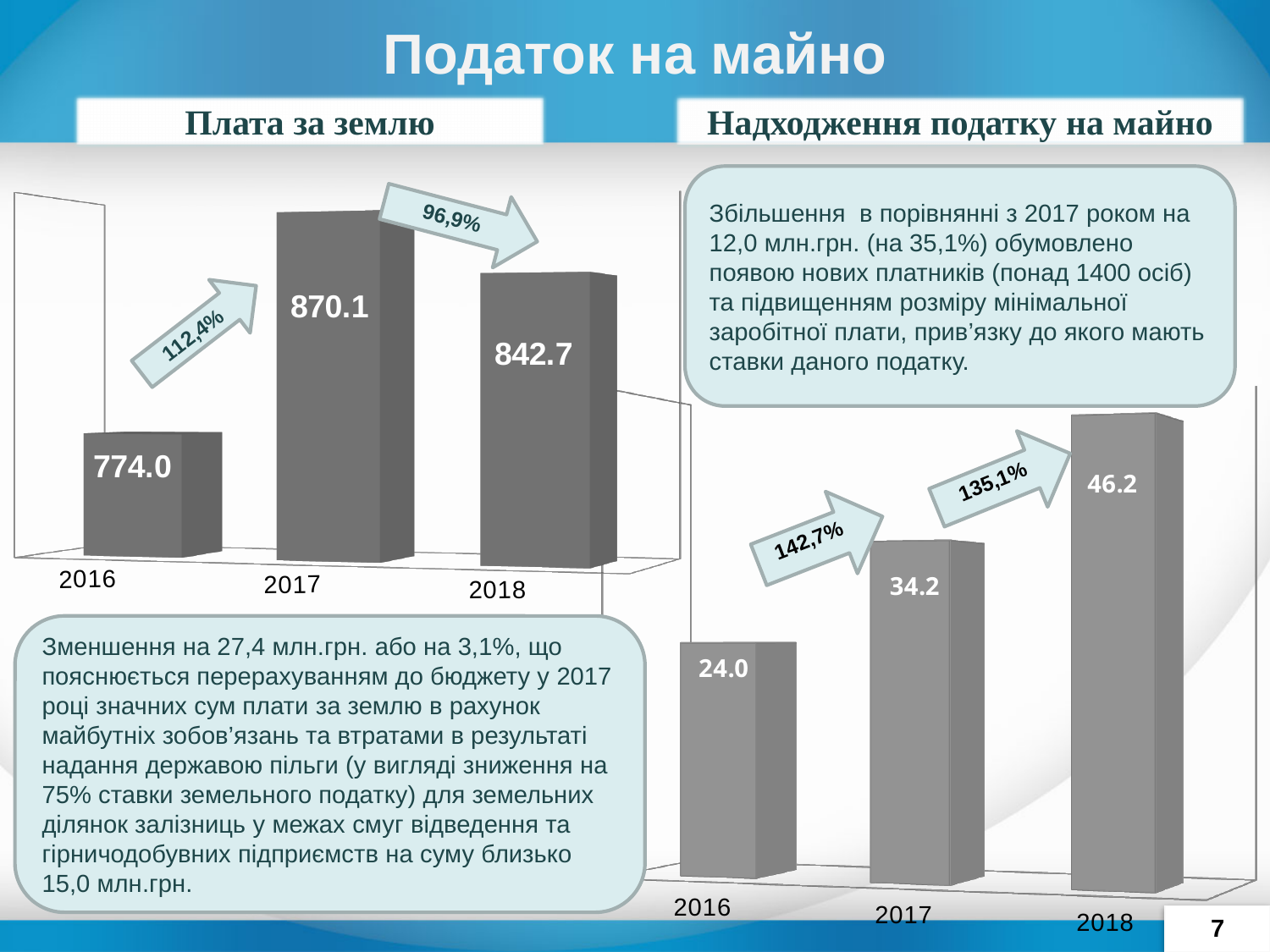
In the 'Плата за землю' chart, what is the difference between the 2017 and 2018 values? 27.4 In the 'Надходження податку на майно' chart, what is the value for 2018? 46.2 In the 'Надходження податку на майно' chart, what is the value for 2016? 24.0 In the 'Надходження податку на майно' chart, do the values rise or fall from 2016 to 2018? rise In the 'Надходження податку на майно' chart, which year has the highest value? 2018 In the 'Плата за землю' chart, which year has the lowest value? 2016 What type of chart is the 'Надходження податку на майно' chart? bar chart In the 'Плата за землю' chart, what is the value for 2017? 870.1 In the 'Надходження податку на майно' chart, what is the difference between the 2018 and 2017 values? 12.0 In the 'Плата за землю' chart, how many bars are plotted? 3 In the 'Плата за землю' chart, what is the value for 2016? 774.0 In the 'Плата за землю' chart, which year has the highest value? 2017